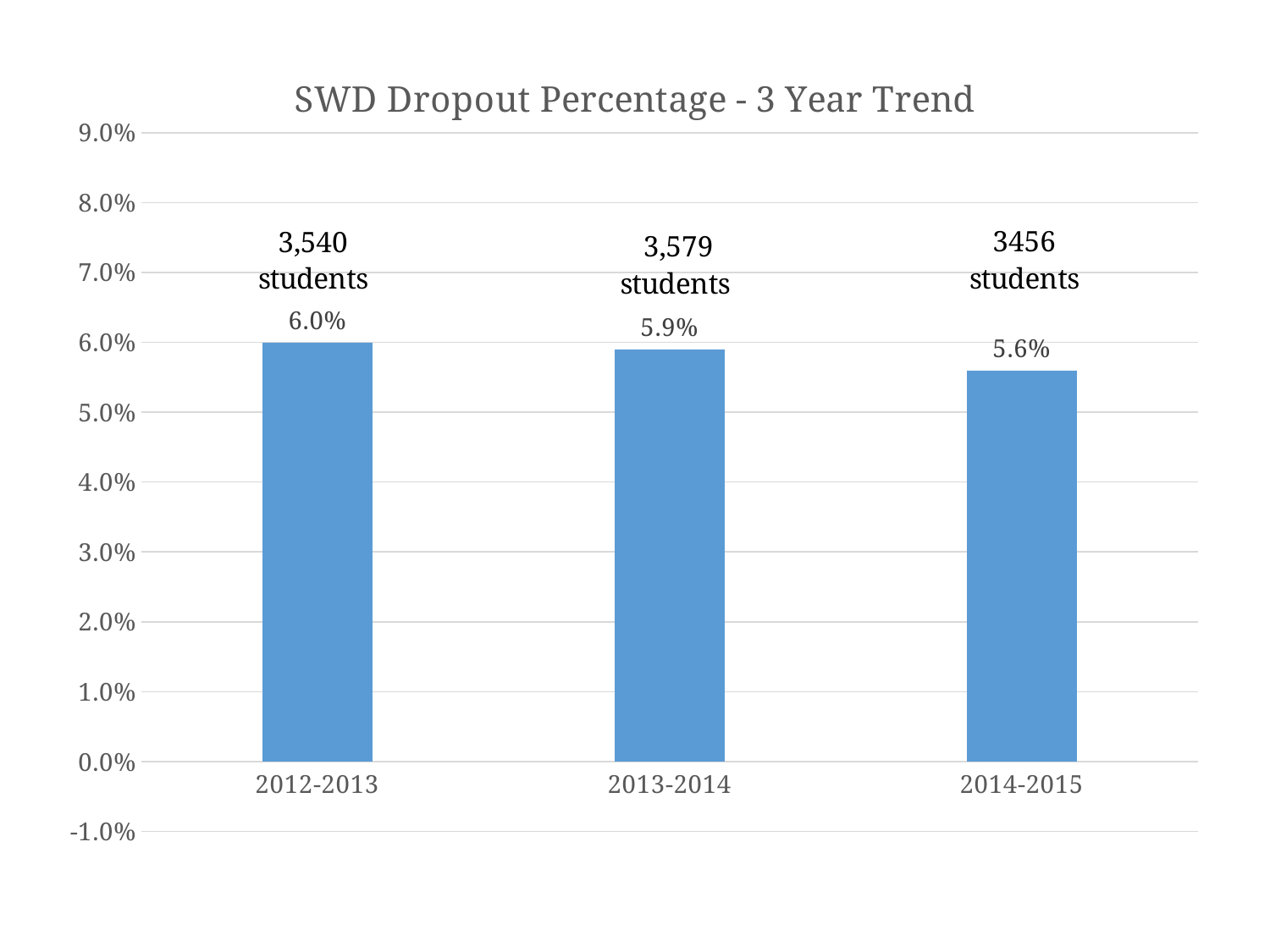
What is the SWD dropout percentage for 2013-2014? 5.9% What is the SWD dropout percentage for 2014-2015? 5.6% What is the difference in dropout percentage between 2012-2013 and 2014-2015? 0.4% Which has a higher dropout percentage, 2013-2014 or 2014-2015? 2013-2014 Which year has the lowest dropout percentage? 2014-2015 How many years are shown on the chart? 3 What is the SWD dropout percentage for 2012-2013? 6.0% What kind of chart is shown? Bar chart Which year has the highest dropout percentage? 2012-2013 How many students are noted above the 2014-2015 bar? 3456 students Does the dropout percentage rise or fall from 2012-2013 to 2014-2015? Fall How many students are noted above the 2013-2014 bar? 3,579 students